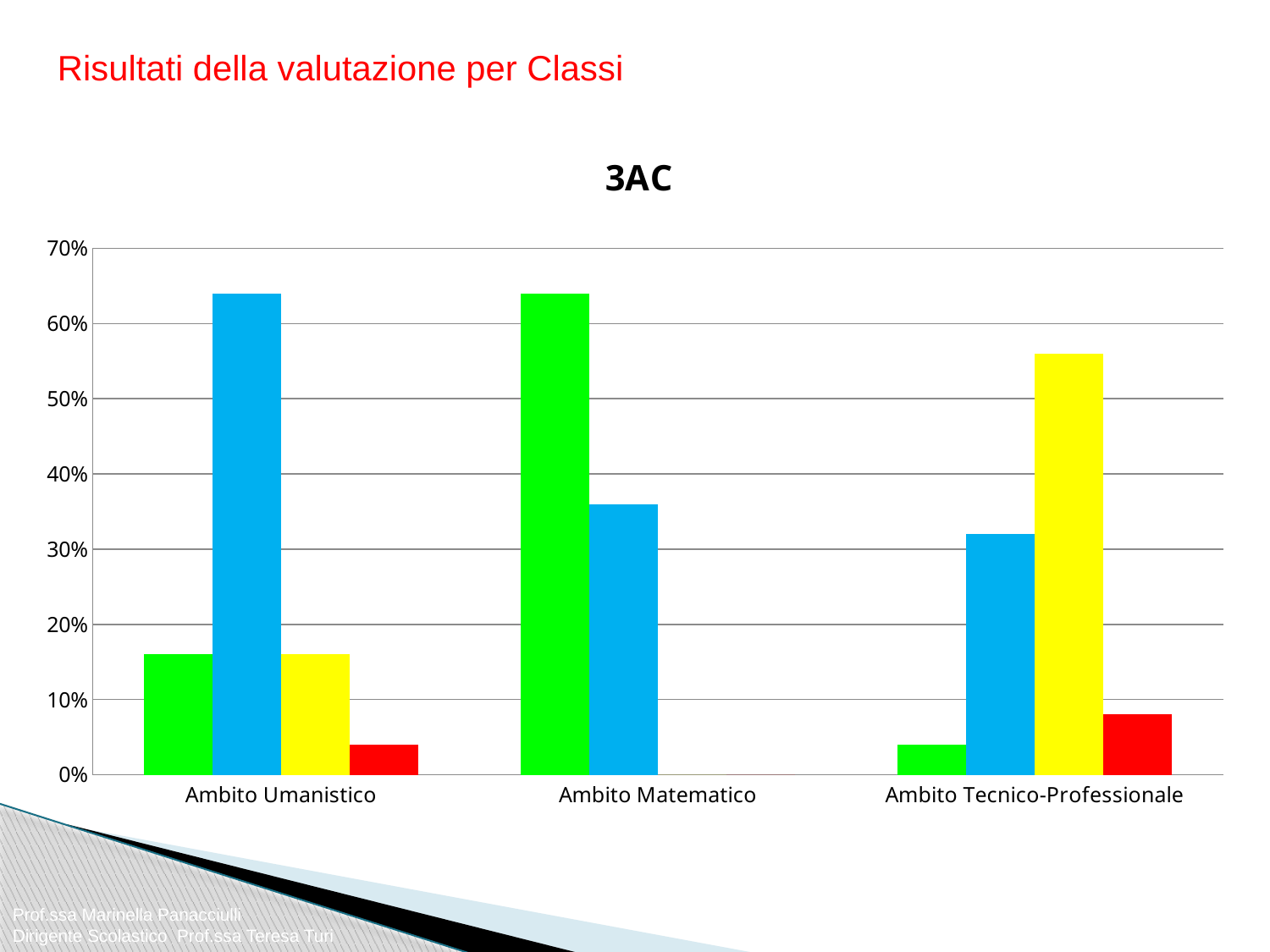
What is the title of the chart? 3AC Is the value of the red bar for Ambito Tecnico-Professionale greater or less than 10%? less For Ambito Tecnico-Professionale, which coloured bar is the tallest? yellow What kind of chart is shown on the slide? bar chart For Ambito Umanistico, which is larger: the blue bar or the green bar? the blue bar For Ambito Tecnico-Professionale, which is larger: the yellow bar or the blue bar? the yellow bar Is the value of the green bar for Ambito Matematico greater or less than 60%? greater How many categories are shown on the x axis of the chart? 3 Is the value of the blue bar for Ambito Matematico greater or less than 40%? less Which category has only two bars plotted? Ambito Matematico